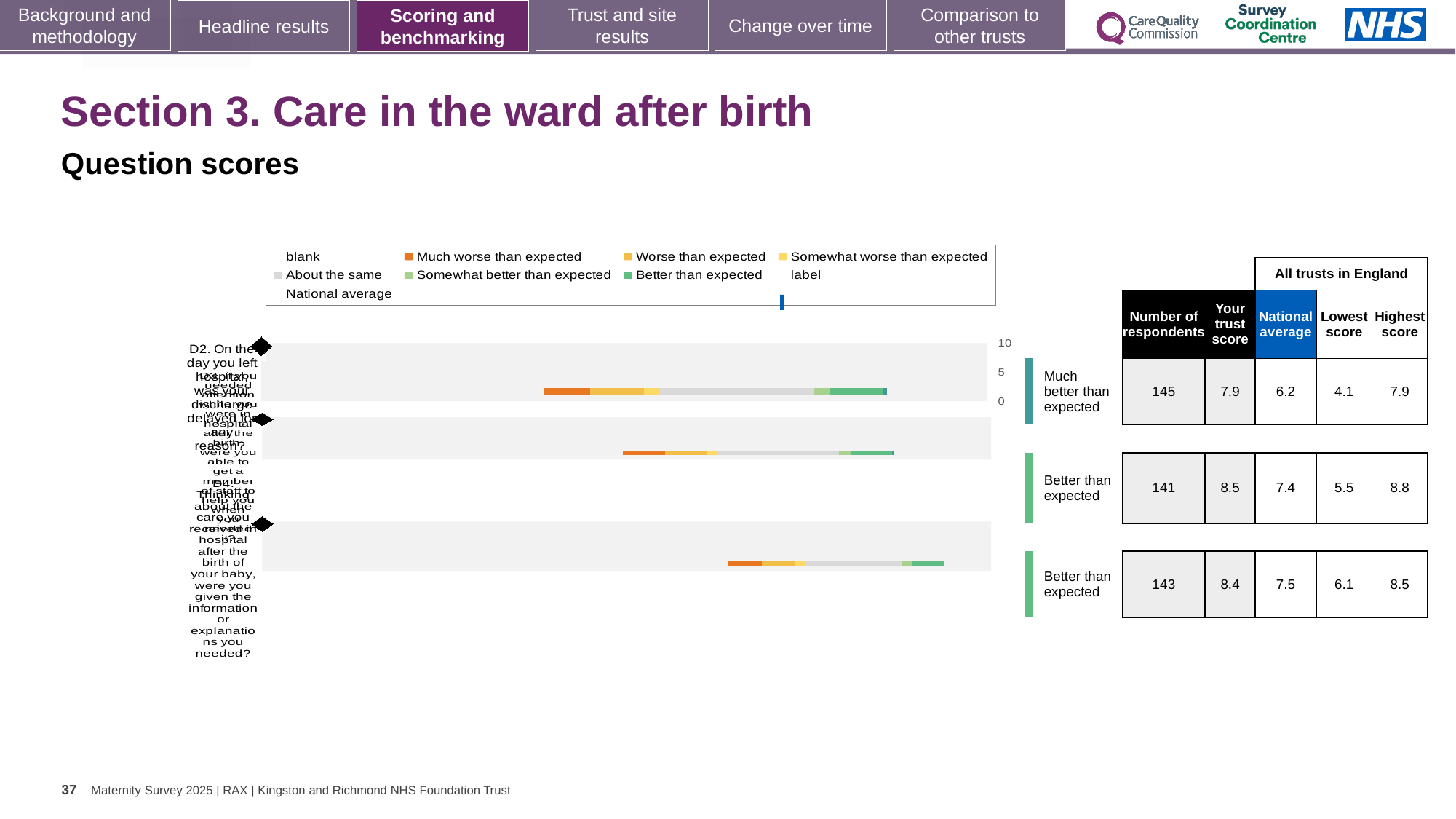
What is the highest tick value shown on the chart's score axis? 10 In the table beside the chart, is the trust score in the third row (8.4) larger or smaller than the national average (7.5)? larger How many question bars are plotted in the chart? 3 What rating label is shown next to the first (top) bar of the chart? Much better than expected In the table beside the chart, how many respondents are listed for the third row? 143 In the table beside the chart, what is the National average for the second row? 7.4 In the table beside the chart, what is the difference between the trust score and the national average in the first row? 1.7 What kind of chart is shown on the slide? bar chart What rating label is shown next to the second bar of the chart? Better than expected What colour does the legend use for 'Much worse than expected'? orange In the table beside the chart, which row has the highest 'Your trust score'? the second row (8.5) In the table beside the chart, what is the 'Your trust score' for the first row (Much better than expected)? 7.9